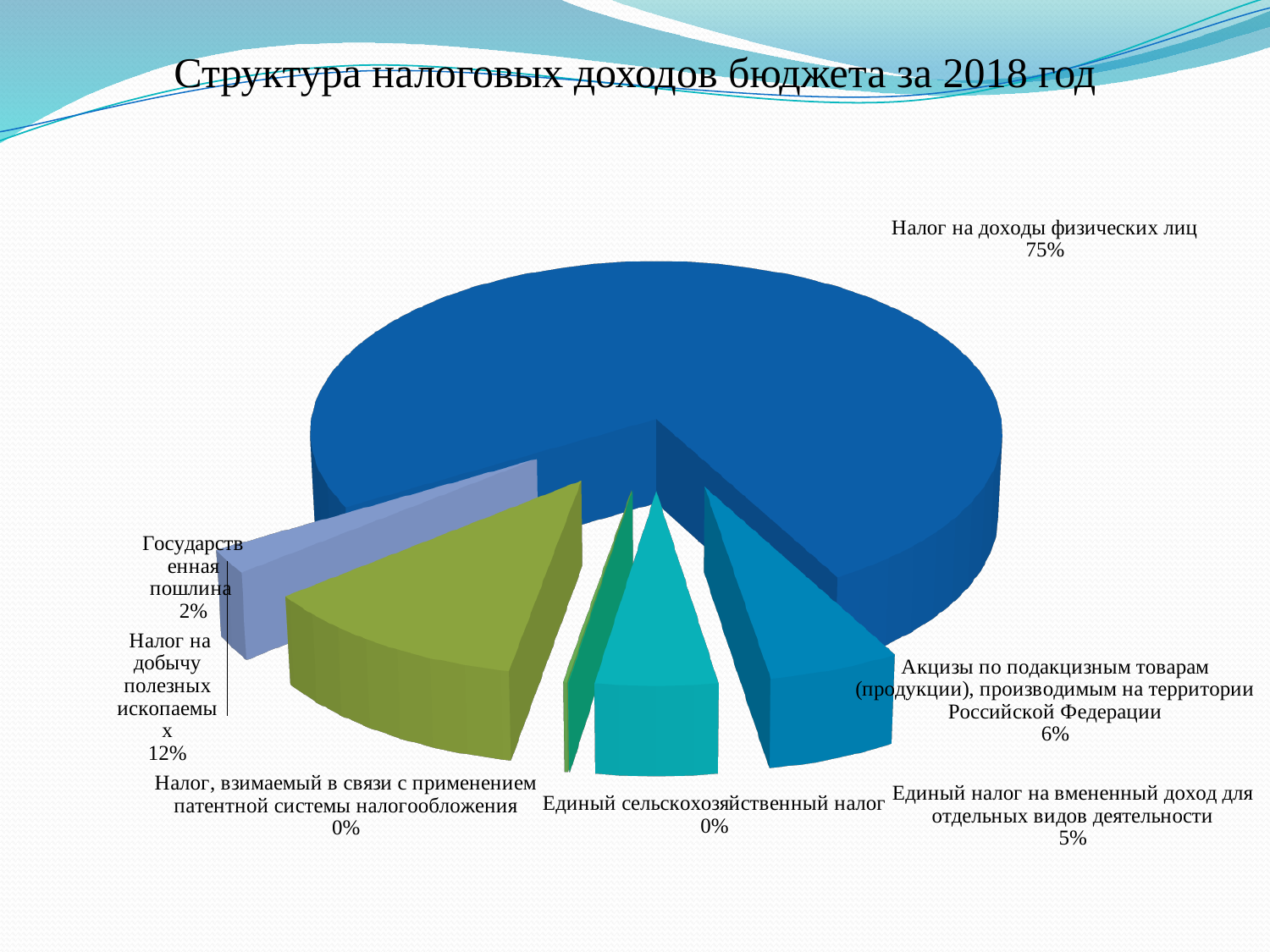
What share of the pie does "Государственная пошлина" have? 2% What share of the pie does "Единый сельскохозяйственный налог" have? 0% What share of the pie does "Акцизы по подакцизным товарам (продукции), производимым на территории Российской Федерации" have? 6% What is the title of the chart on the slide? Структура налоговых доходов бюджета за 2018 год Which category has the largest share of the pie? Налог на доходы физических лиц Which is larger: the share for "Акцизы по подакцизным товарам (продукции), производимым на территории Российской Федерации" or for "Единый налог на вмененный доход для отдельных видов деятельности"? Акцизы по подакцизным товарам (продукции), производимым на территории Российской Федерации What kind of chart is shown on the slide? Pie chart What is the difference in percentage points between "Налог на доходы физических лиц" and "Налог на добычу полезных ископаемых"? 63 How many categories are shown in the pie chart? 7